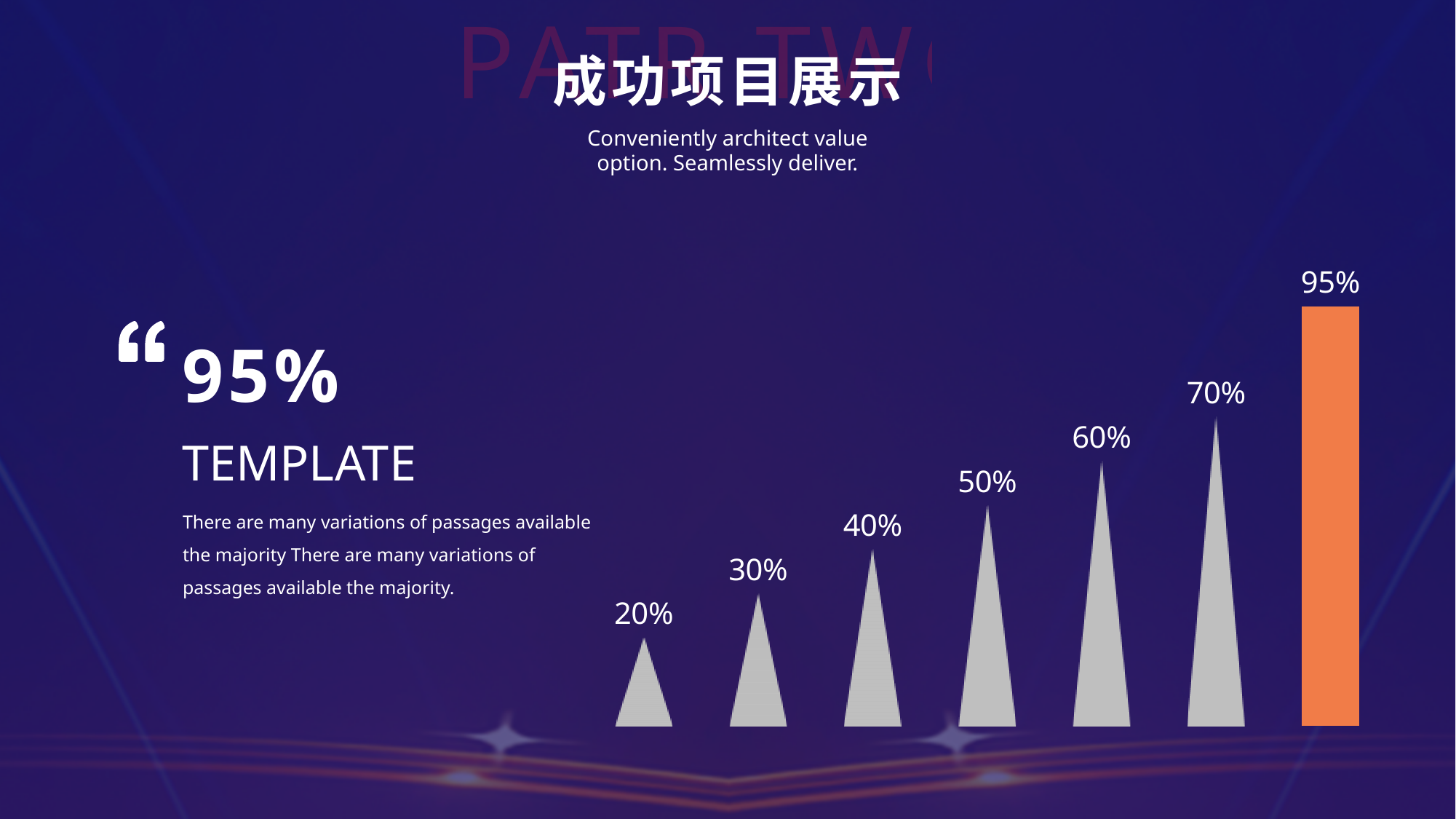
Which is larger, the value of the second bar from the left or the value of the fifth bar from the left? the fifth bar (60%) What is the difference between the rightmost bar's value and the sixth bar's value? 25% What is the value shown on the third bar from the left in the chart? 40% What is the difference between the fourth bar's value and the leftmost bar's value? 30% What is the highest value shown in the chart? 95% What is the lowest value shown in the chart? 20% What is the value shown on the leftmost bar of the chart? 20% What is the value shown on the sixth bar from the left in the chart? 70% What is the value shown on the rightmost bar of the chart? 95% What colour is the tallest bar in the chart? orange How many bars are plotted in the chart? 7 Do the values rise or fall from left to right across the chart? rise